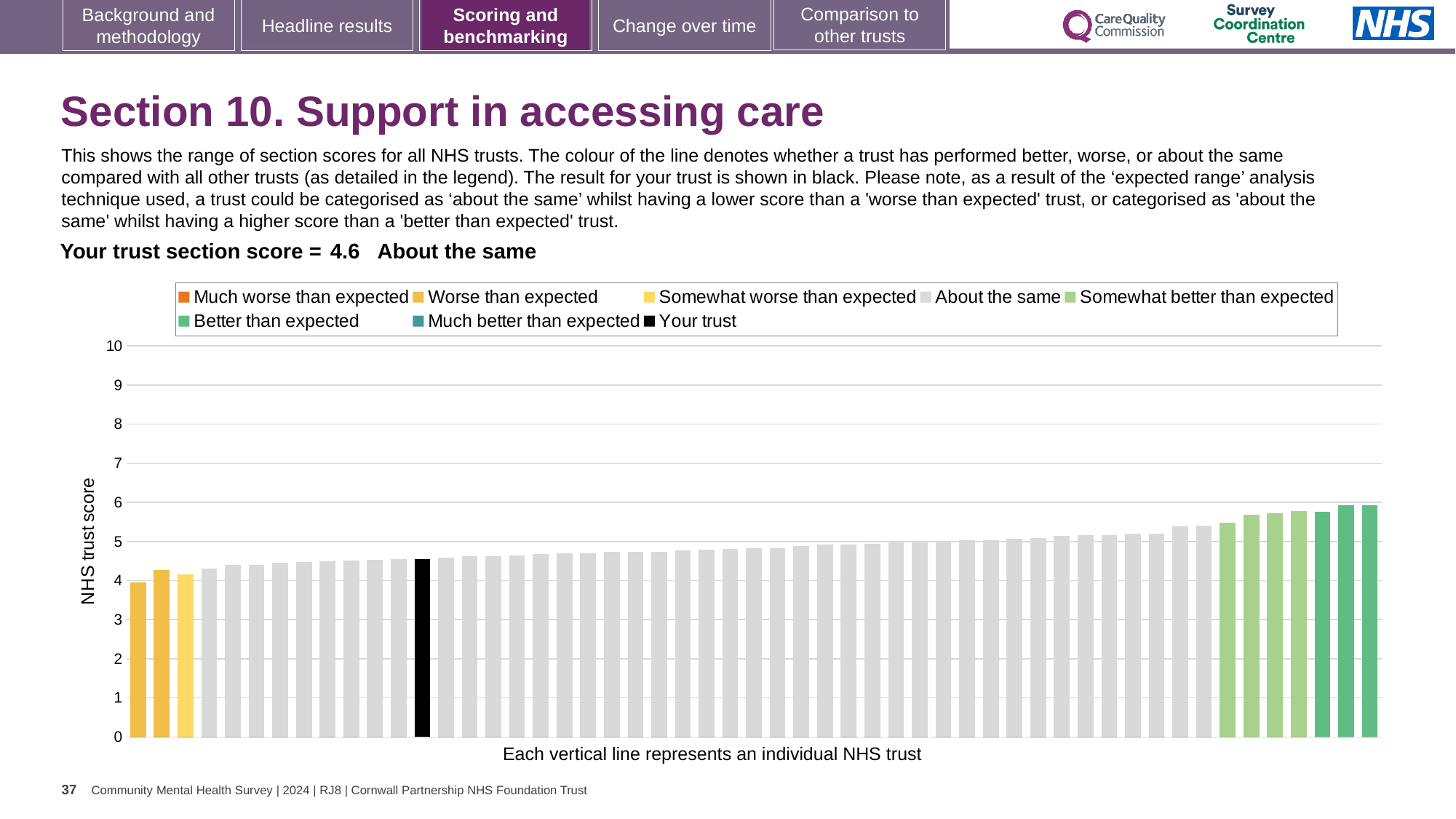
Is the value of the highest bar on the chart greater or less than 5? greater What kind of chart is used to show the range of section scores? bar chart How many entries does the chart legend list? 8 What is the section score for your trust shown on the chart? 4.6 Which legend category does the lowest bar on the chart belong to? Worse than expected Which legend category does the highest bar on the chart belong to? Better than expected What is the label on the vertical axis of the chart? NHS trust score Is the value of the lowest bar on the chart greater or less than 5? less Do the bar values rise or fall from left to right along the x axis? rise Is the value of the highest bar on the chart greater or less than 6? less What colour is the bar representing your trust? black